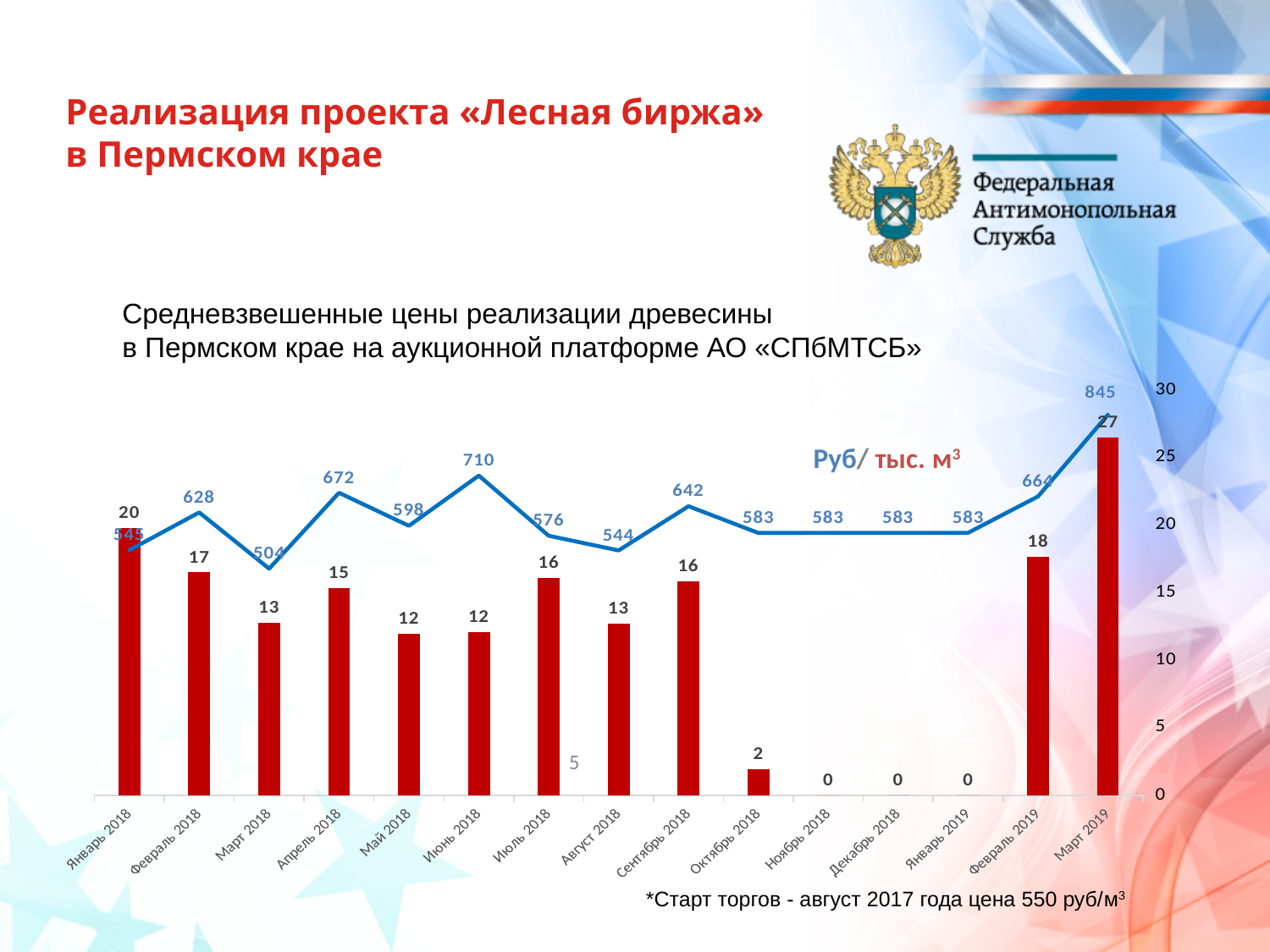
What is the line value (руб) for Март 2019? 845 What units are shown in the chart's legend label? Руб/ тыс. м³ What is the bar value for Октябрь 2018? 2 What is the line value (руб) for Июнь 2018? 710 Which month has the highest bar value? Март 2019 What is the difference between the line values for Март 2019 and Февраль 2019? 181 How many months are shown on the x axis? 15 What is the bar value (тыс. м³) for Январь 2018? 20 What is the difference between the bar values for Март 2019 and Февраль 2019? 9 How many months have a bar value of 0? 3 Which month has the lowest line value (руб)? Март 2018 Which is larger, the bar value for Апрель 2018 or for Май 2018? Апрель 2018